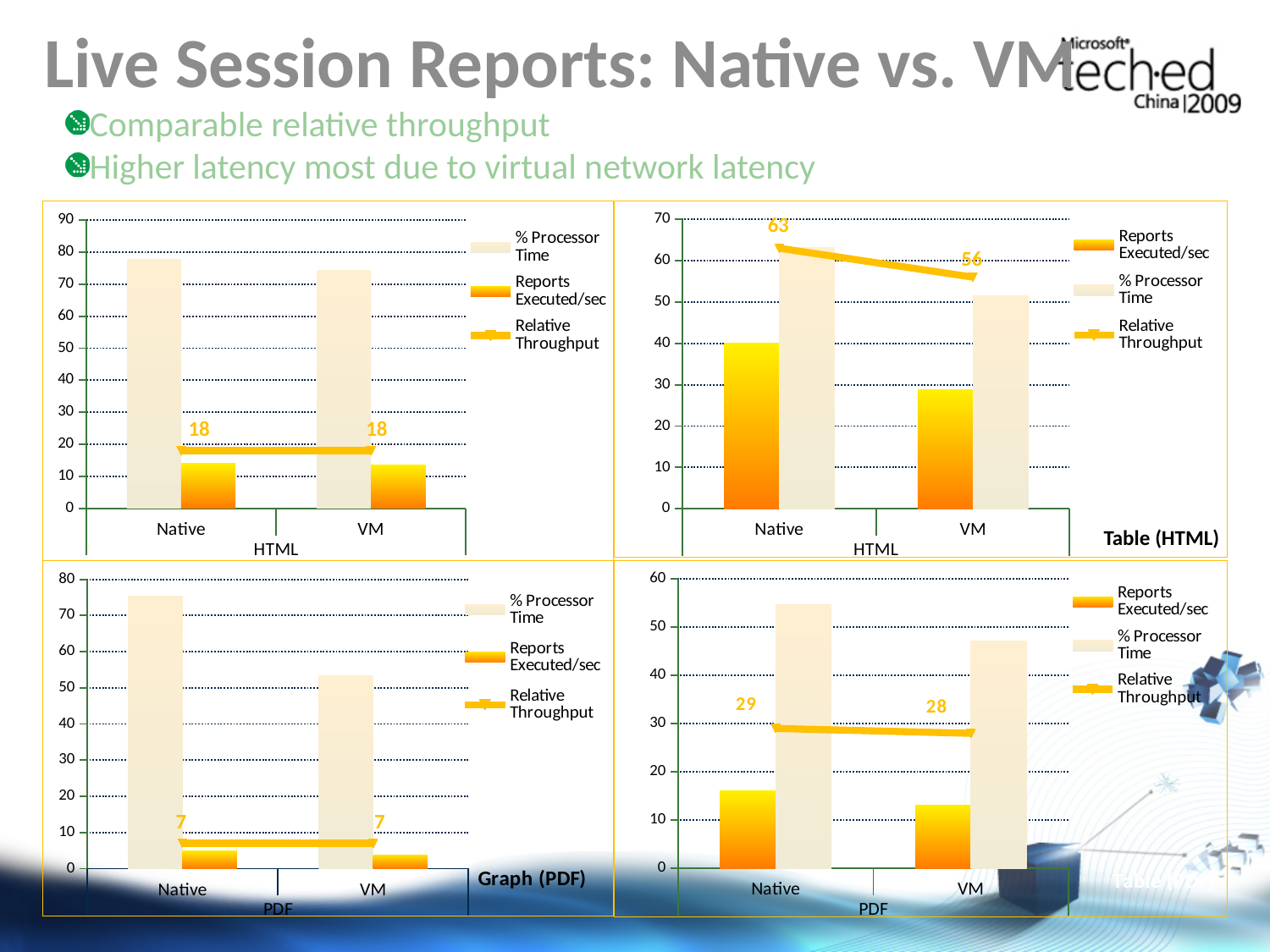
In the top-right chart (Table (HTML)), is the Reports Executed/sec value for Native greater or less than 30? greater In the top-right chart (Table (HTML)), what is the Relative Throughput value for Native? 63 In the bottom-left chart (Graph (PDF)), is the % Processor Time value for VM greater or less than 60? less In the bottom-right chart (PDF), what is the difference between the Relative Throughput values for Native and VM? 1 In the bottom-left chart (Graph (PDF)), what is the Relative Throughput value for Native? 7 In the top-right chart (Table (HTML)), does the Relative Throughput line rise or fall from Native to VM? fall In the top-right chart (Table (HTML)), which has the higher Reports Executed/sec value, Native or VM? Native In the top-right chart (Table (HTML)), what is the difference between the Relative Throughput values for Native and VM? 7 How many series does the legend of the top-left chart (HTML) list? 3 In the bottom-right chart (PDF), what is the Relative Throughput value for Native? 29 In the top-left chart (HTML), what is the Relative Throughput value for VM? 18 In the top-right chart (Table (HTML)), what is the Relative Throughput value for VM? 56